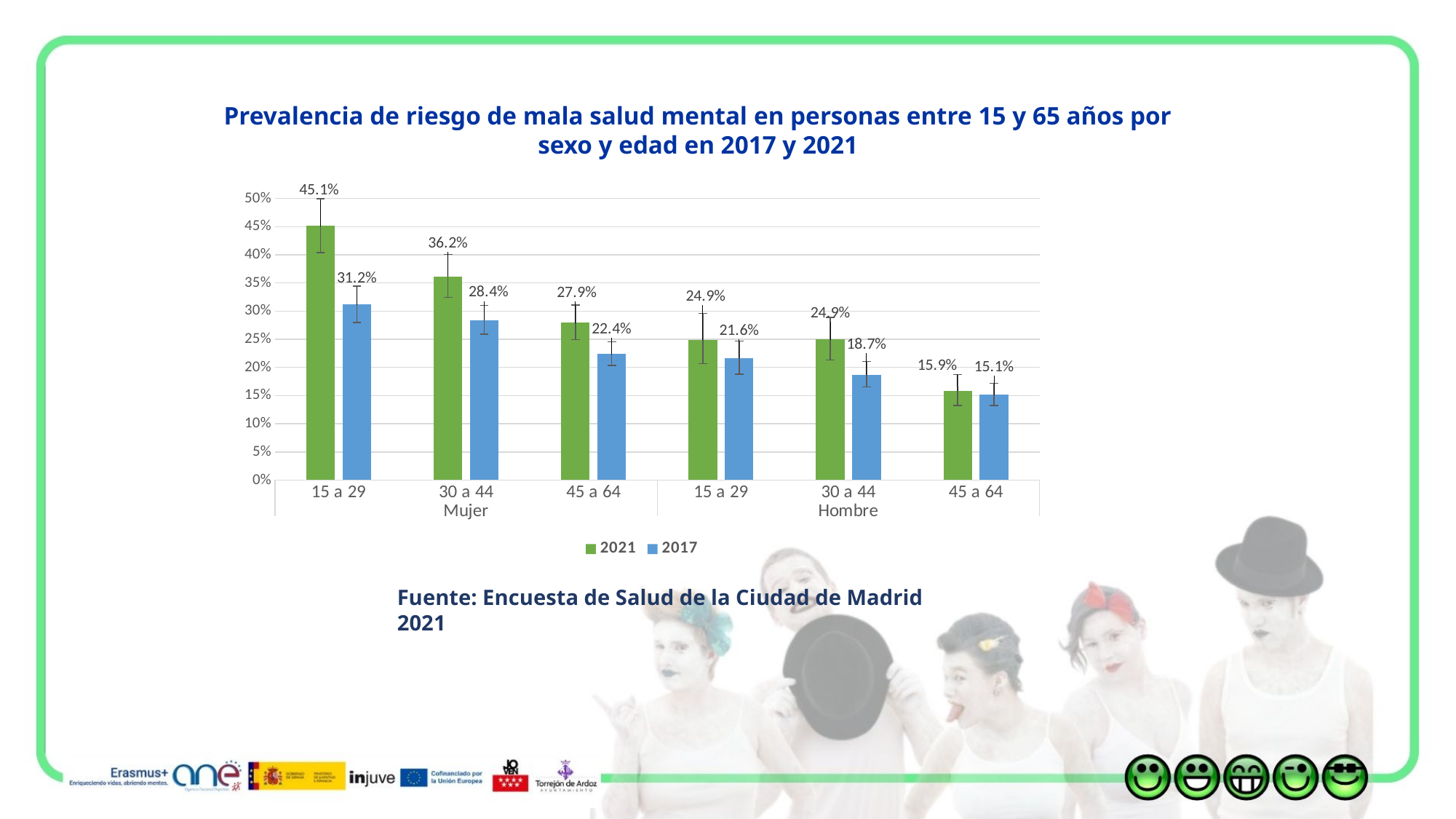
What is the difference between the 2021 and 2017 values for women (Mujer) aged 15 a 29? 13.9% What is the difference between the 2021 and 2017 values for men (Hombre) aged 45 a 64? 0.8% What is the 2017 value for women (Mujer) aged 45 a 64? 22.4% What kind of chart is shown on the slide? Bar chart What is the 2021 value for women (Mujer) aged 15 a 29? 45.1% Which group has the highest 2021 value? Mujer 15 a 29 How many series does the legend list? 2 Which is larger: the 2021 value for women (Mujer) aged 30 a 44 or the 2021 value for men (Hombre) aged 15 a 29? Mujer 30 a 44 Which group has the lowest 2017 value? Hombre 45 a 64 Which colour represents the 2017 series in the legend? Blue What is the 2017 value for men (Hombre) aged 30 a 44? 18.7% How many age-sex groups are shown on the x axis? 6